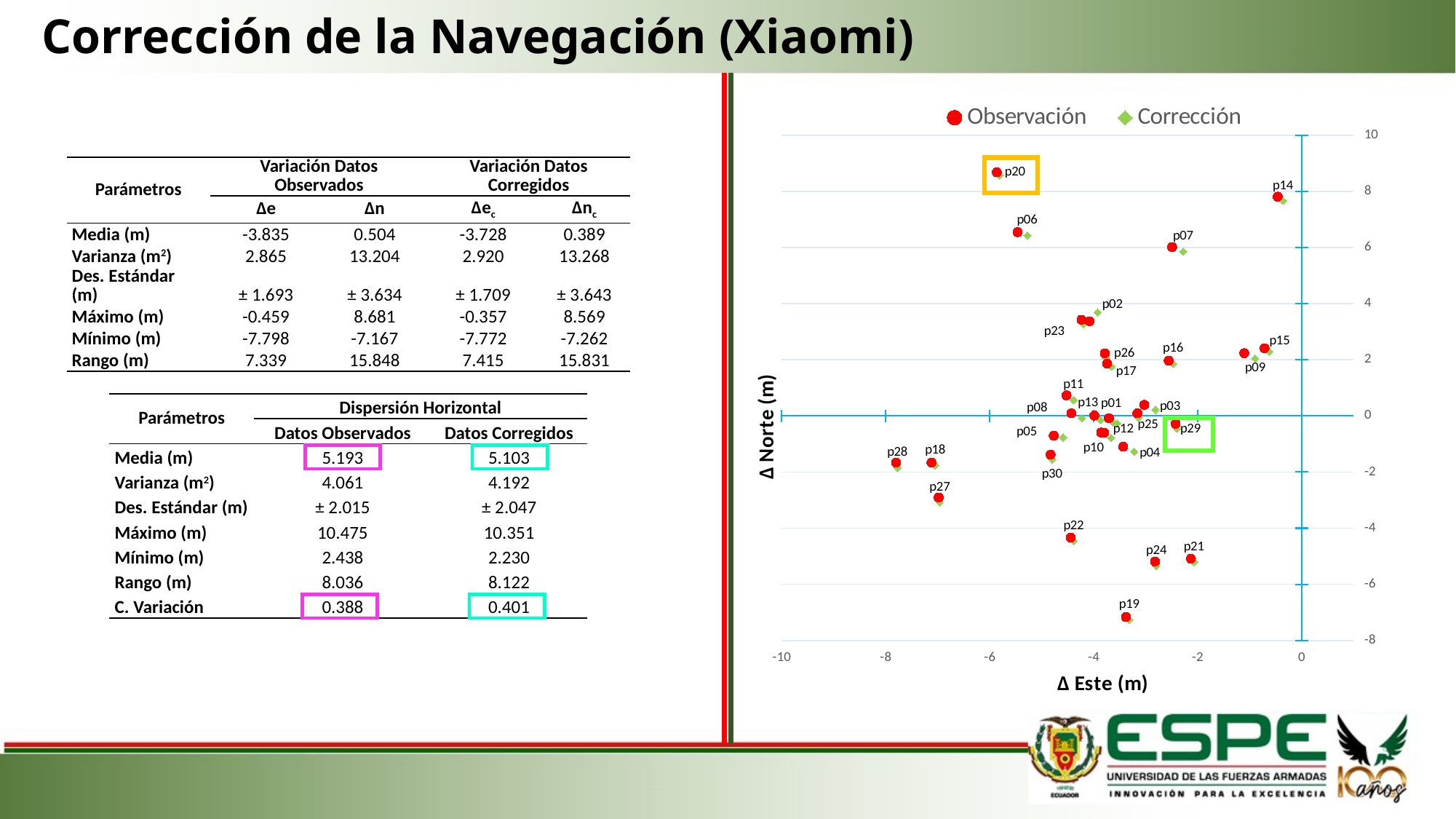
What kind of chart is shown on the right side of the slide? scatter chart Is the Δ Norte value for p19 greater or less than -6? less Which point has a higher Δ Este value, p21 or p28? p21 How many series does the legend of the scatter chart list? 2 Which point has a higher Δ Norte value, p06 or p27? p06 Which point has the lowest Δ Norte value in the scatter chart? p19 Is the Δ Norte value for p07 greater or less than 4? greater Is the Δ Norte value for p20 greater or less than 8? greater What are the two series named in the legend of the scatter chart? Observación and Corrección Which point has the lowest Δ Este value (furthest left) in the scatter chart? p28 What is the title of the horizontal axis of the scatter chart? Δ Este (m)